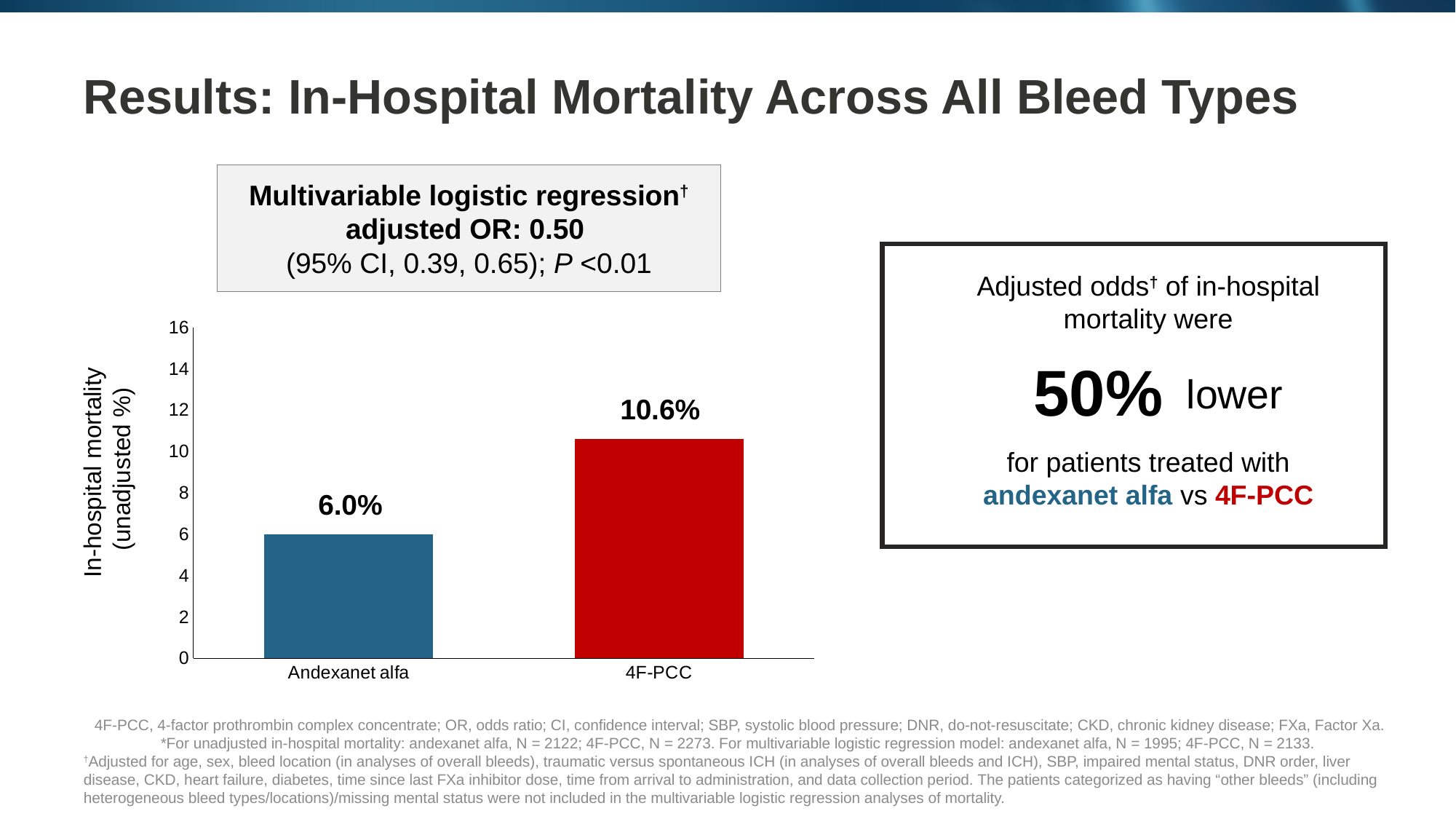
What is the in-hospital mortality for 4F-PCC? 10.6% How many treatment groups are shown in the chart? 2 What is the in-hospital mortality for Andexanet alfa? 6.0% Which treatment has the lower in-hospital mortality? Andexanet alfa What is the label of the y-axis of the chart? In-hospital mortality (unadjusted %) What is the maximum value shown on the y-axis of the chart? 16 Which treatment has the higher in-hospital mortality? 4F-PCC What is the difference in in-hospital mortality between 4F-PCC and Andexanet alfa? 4.6% Is the in-hospital mortality for Andexanet alfa greater or less than 8? less Is the in-hospital mortality for 4F-PCC greater or less than 8? greater What type of chart is shown on the slide? Bar chart Is the in-hospital mortality higher for Andexanet alfa or 4F-PCC? 4F-PCC